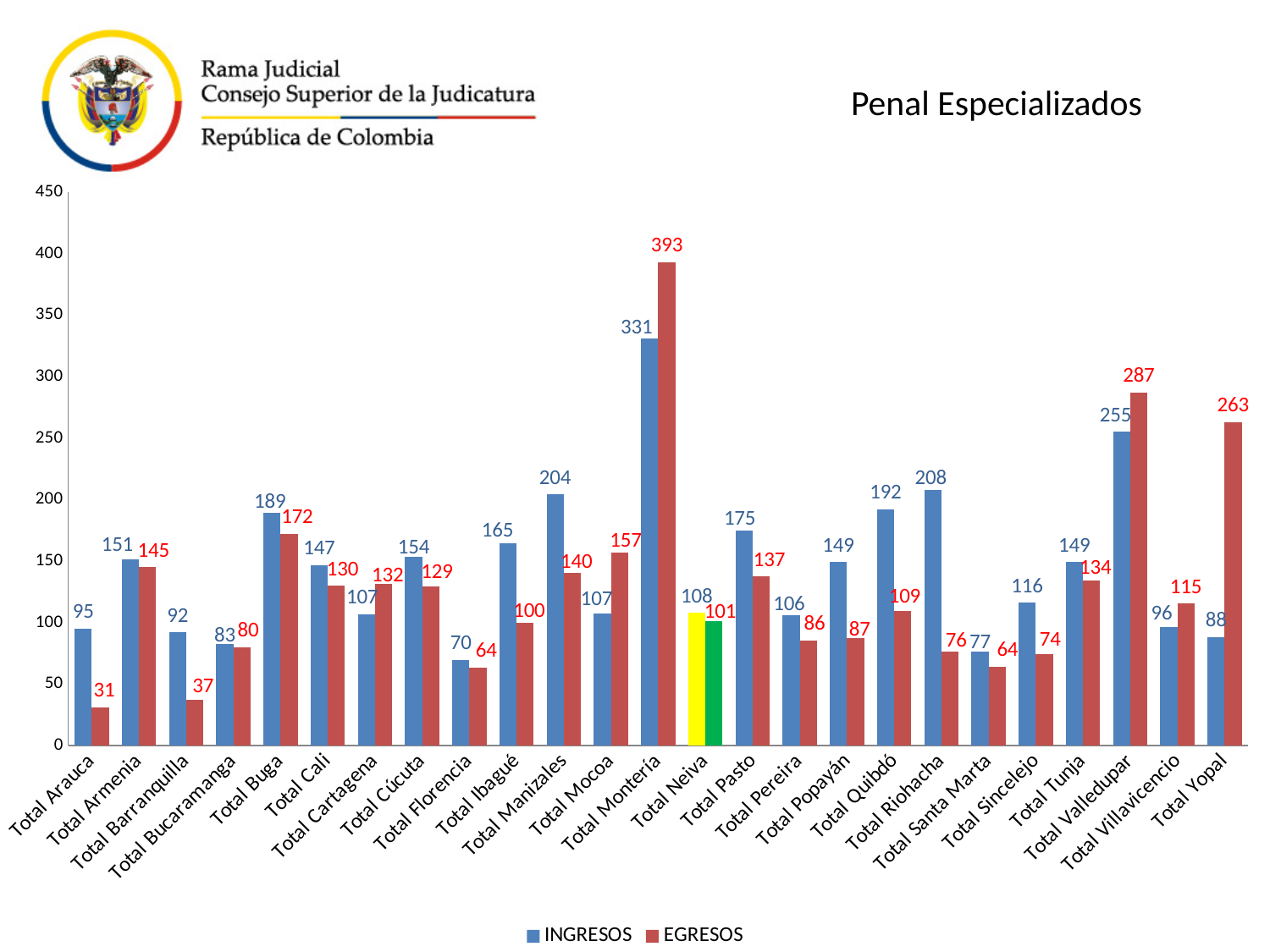
What is the title of the chart? Penal Especializados How many series does the legend list? 2 What kind of chart is shown on the slide? Bar chart What is the INGRESOS value for Total Montería? 331 What is the difference between INGRESOS and EGRESOS for Total Valledupar? 32 Which category has the highest EGRESOS value? Total Montería Which is larger for Total Mocoa, INGRESOS or EGRESOS? EGRESOS Which is larger for Total Riohacha, INGRESOS or EGRESOS? INGRESOS How many categories are shown on the x axis? 25 What is the EGRESOS value for Total Arauca? 31 What is the EGRESOS value for Total Yopal? 263 Which category has the lowest INGRESOS value? Total Florencia